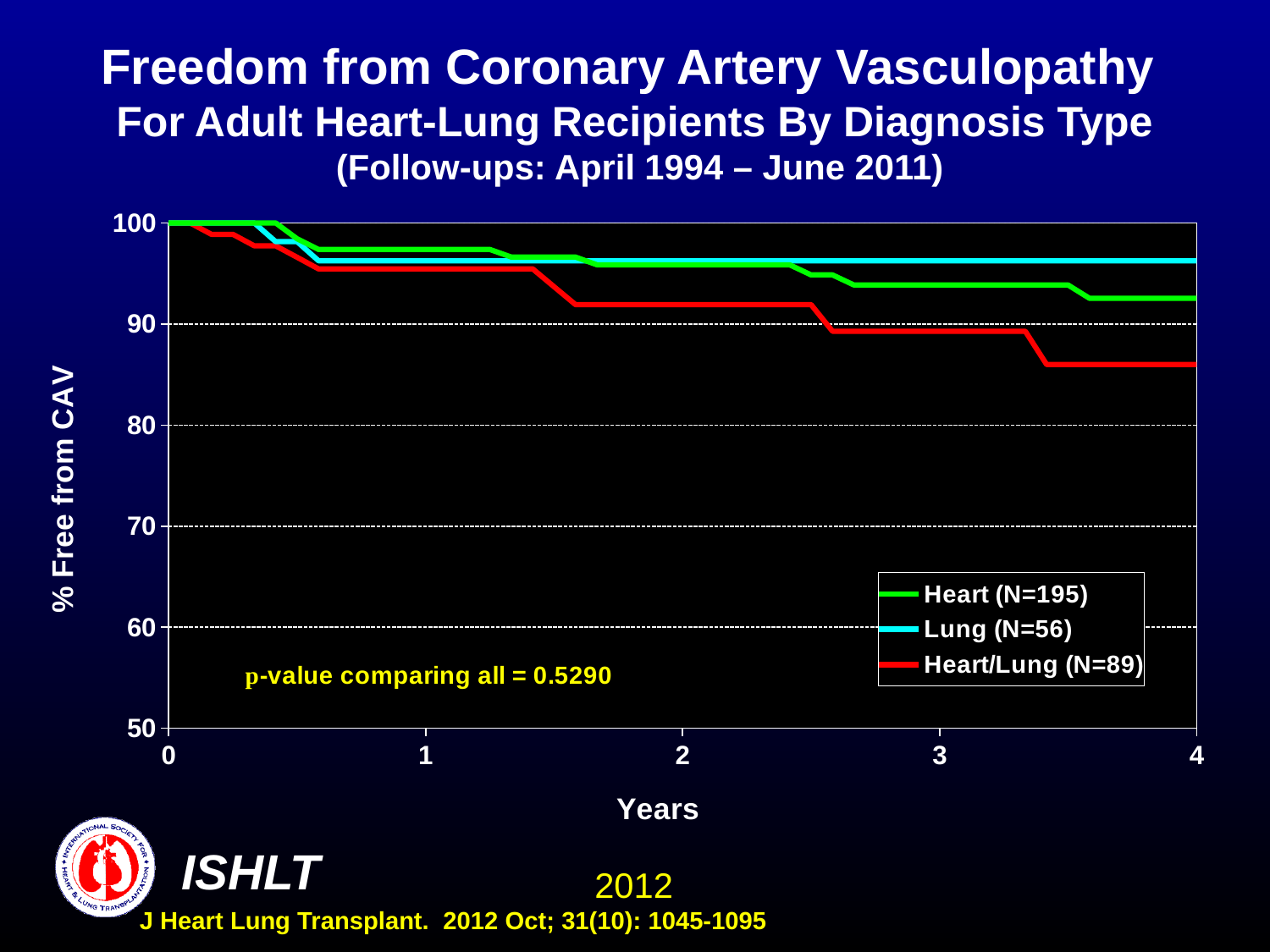
Is the value for Heart/Lung (N=89) at 4 years greater or less than 90? less What kind of chart is shown on the slide? line chart How many series does the legend list? 3 Is the value for Heart/Lung (N=89) at 2 years greater or less than 90? greater Is the value for Lung (N=56) at 4 years greater or less than 90? greater Which series has the lowest % free from CAV at 4 years? Heart/Lung (N=89) Which series has the highest % free from CAV at 4 years? Lung (N=56) At 4 years, which series is higher: Lung (N=56) or Heart/Lung (N=89)? Lung (N=56) What is the label of the y axis? % Free from CAV Do the values for Heart/Lung (N=89) rise or fall as years increase? fall What p-value comparing all groups is printed on the chart? 0.5290